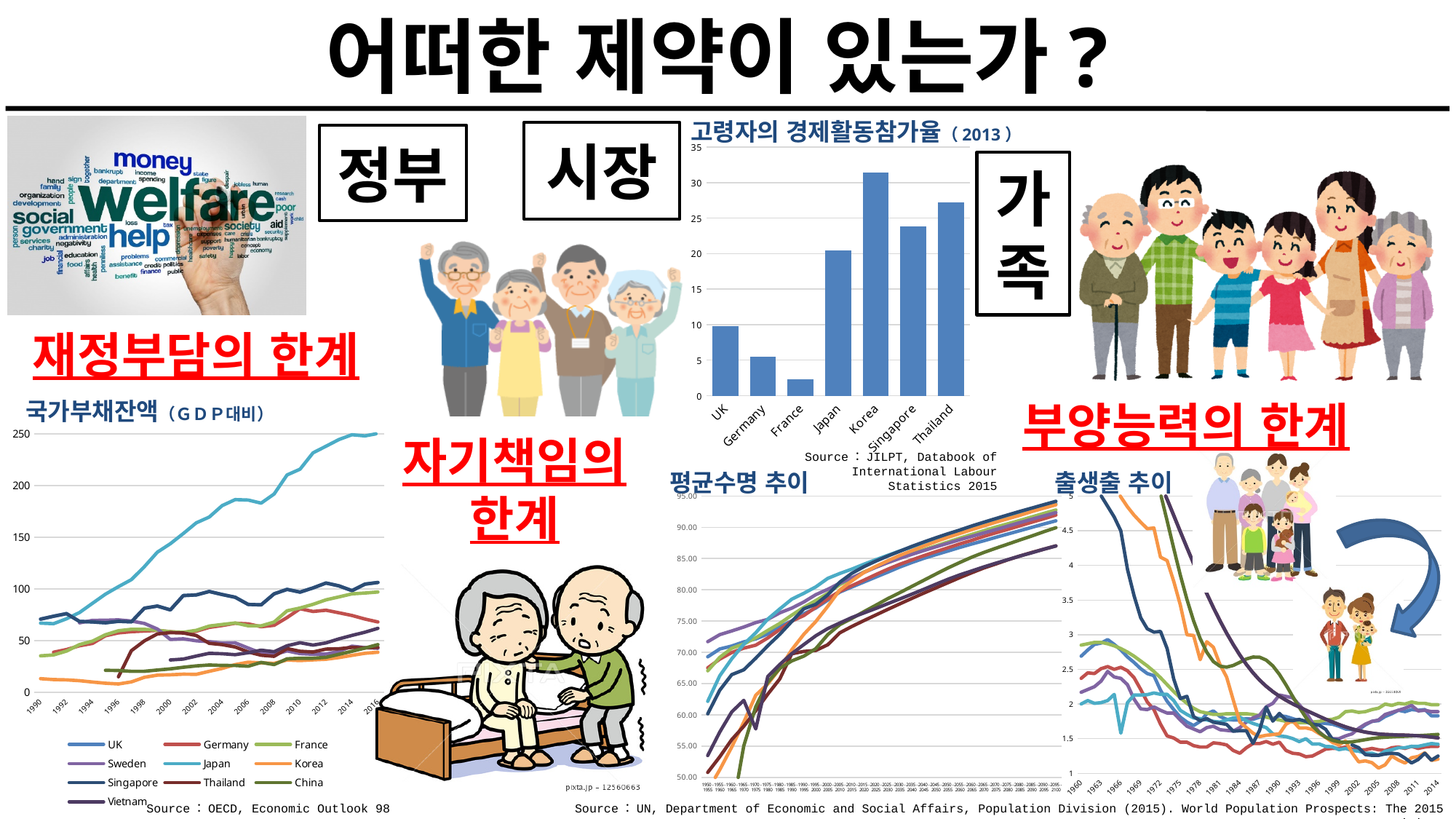
In the '고령자의 경제활동참가율 (2013)' chart, which country has the lowest value? France How many series does the legend of the '국가부채잔액 (GDP대비)' chart list? 10 In the '국가부채잔액 (GDP대비)' chart, is the value for Japan in 2016 greater or less than 200? greater In the '고령자의 경제활동참가율 (2013)' chart, is the value for Korea greater or less than 30? greater In the '고령자의 경제활동참가율 (2013)' chart, which country has the highest value? Korea In the '고령자의 경제활동참가율 (2013)' chart, which is larger, the value for Japan or the value for Thailand? Thailand In the '고령자의 경제활동참가율 (2013)' chart, is the value for France greater or less than 5? less How many countries are shown in the '고령자의 경제활동참가율 (2013)' bar chart? 7 In the '출생출 추이' chart, do the values generally rise or fall over time? fall In the '국가부채잔액 (GDP대비)' chart, which country has the highest value in 2016? Japan What kind of chart is the '고령자의 경제활동참가율 (2013)' chart? bar chart